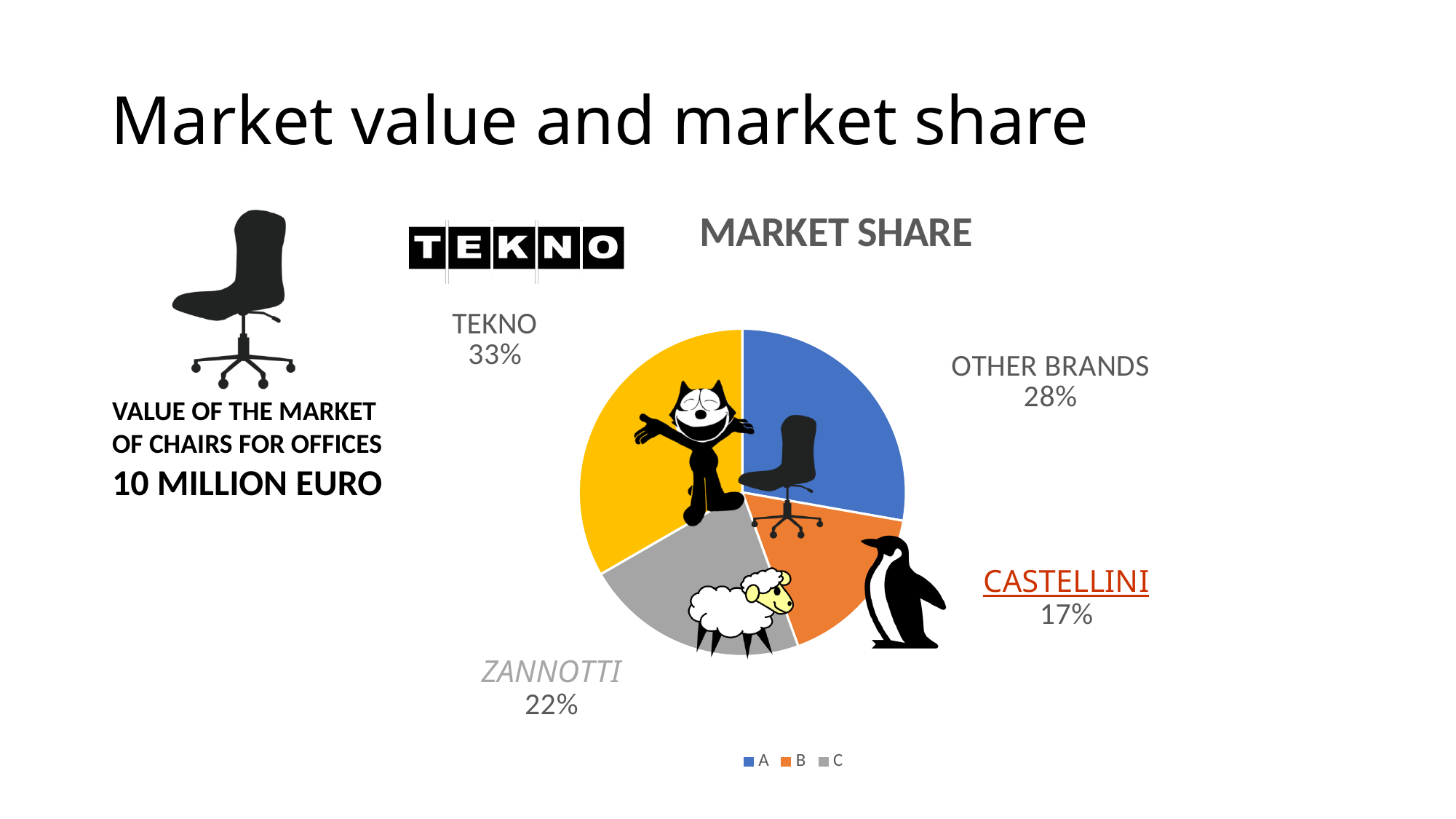
Which has a larger market share, ZANNOTTI or OTHER BRANDS? OTHER BRANDS What is the title of the chart? MARKET SHARE What is the difference in market share between TEKNO and CASTELLINI? 16% Which brand has the largest market share? TEKNO Which brand has the smallest market share? CASTELLINI What market share do OTHER BRANDS have? 28% What market share does CASTELLINI have? 17% What market share does ZANNOTTI have? 22% What market share does TEKNO have? 33% How many entries does the legend list? 3 What kind of chart is shown on the slide? pie chart How many slices does the pie chart have? 4